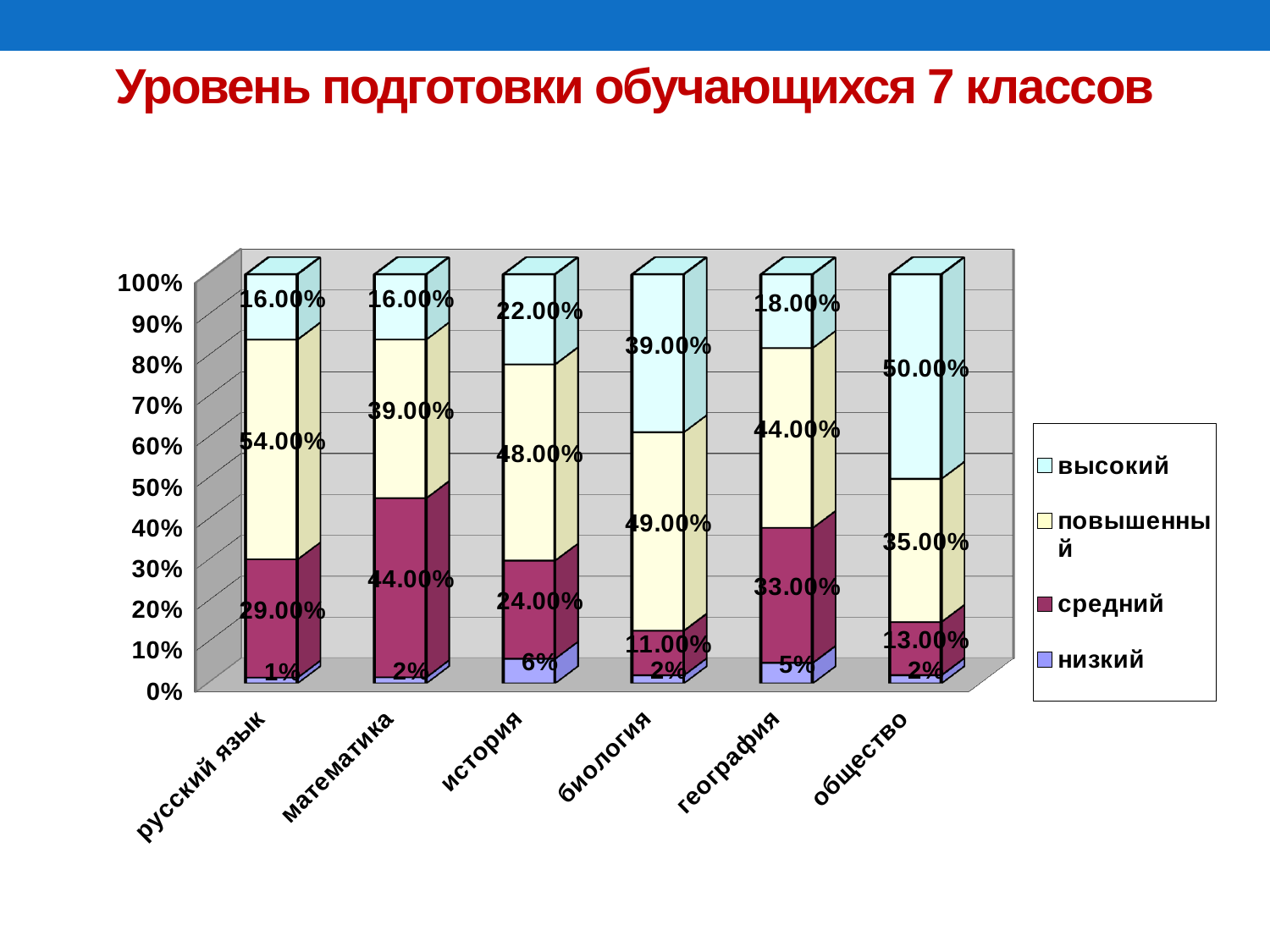
What is the title of the slide? Уровень подготовки обучающихся 7 классов How many categories are shown on the x axis? 6 What kind of chart is shown on the slide? stacked bar chart What is the value of the "повышенный" series for биология? 49.00% What is the value of the "средний" series for математика? 44.00% What is the value of the "низкий" series for история? 6% What is the difference between the "высокий" values for биология and география? 21.00% Which is larger: the "средний" value for география or for история? география What is the value of the "высокий" series for общество? 50.00% How many series does the legend list? 4 Which category has the lowest value for the "средний" series? биология Which category has the highest value for the "повышенный" series? русский язык